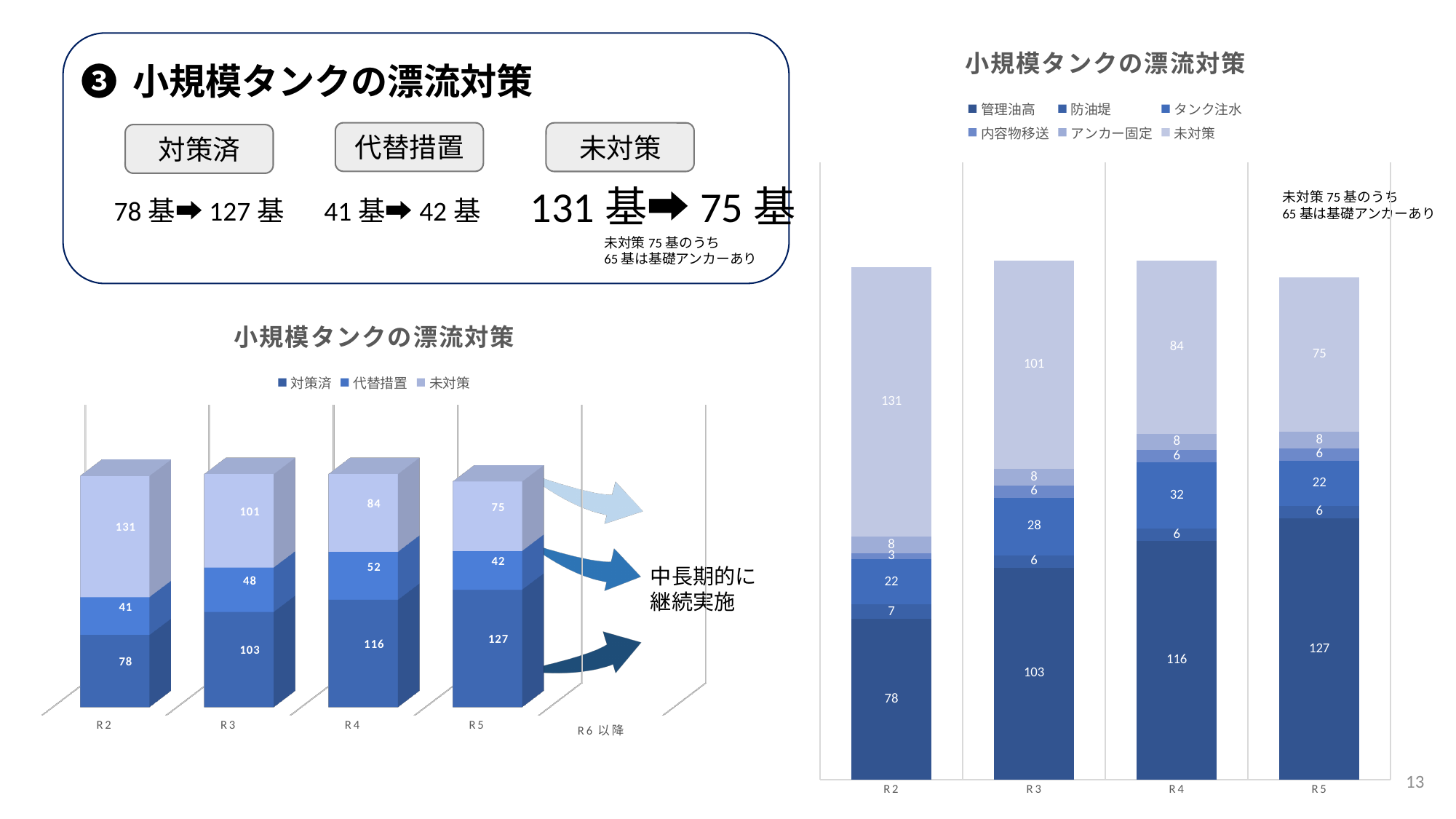
In the left chart, what is the value of 対策済 for R5? 127 What kind of chart is the right chart? stacked bar chart In the right chart, what is the value of 内容物移送 for R2? 3 In the left chart, does the 対策済 value rise or fall from R2 to R5? rise In the right chart, which is larger, the 防油堤 value for R3 or for R5? They are equal (both 6) In the left chart, what is the value of 未対策 for R2? 131 In the left chart, which category has the lowest 対策済 value? R2 In the left chart, what is the total of the stacked bar for R5? 244 In the right chart, what is the value of 防油堤 for R4? 6 In the left chart, which category has the highest 未対策 value? R2 How many series does the legend of the right chart list? 6 In the left chart, what is the difference between the 未対策 values for R2 and R5? 56